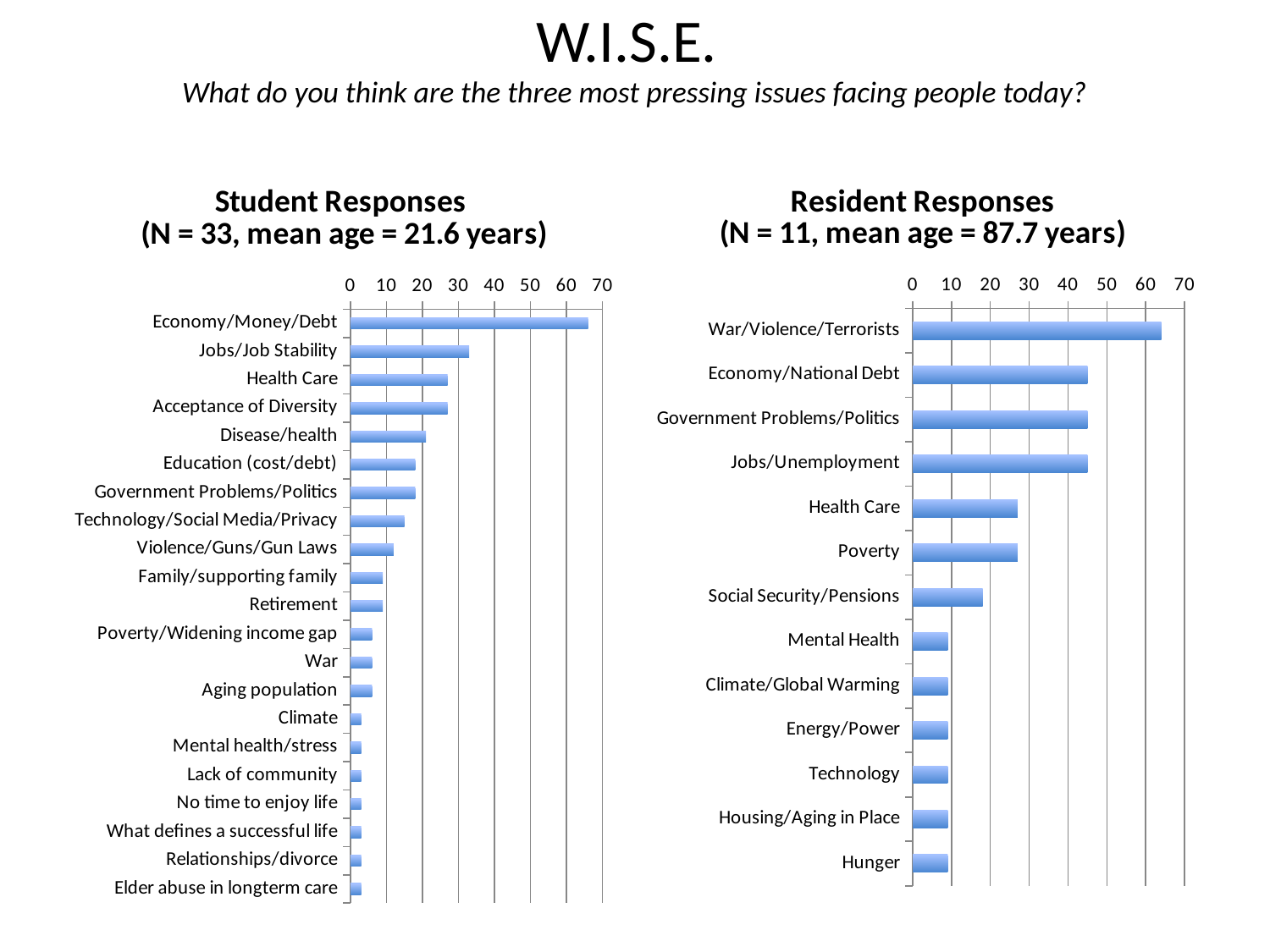
In the Student Responses chart, is the value for Jobs/Job Stability greater or less than 30? greater In the Resident Responses chart, is the value for Social Security/Pensions greater or less than 20? less In the Student Responses chart, which category has the highest value? Economy/Money/Debt How many categories are shown in the Resident Responses chart? 13 What kind of chart is the Student Responses chart? bar chart In the Student Responses chart, which is larger: Economy/Money/Debt or Jobs/Job Stability? Economy/Money/Debt In the Student Responses chart, is the value for Education (cost/debt) greater or less than 20? less In the Resident Responses chart, which category has the highest value? War/Violence/Terrorists How many categories are shown in the Student Responses chart? 21 In the Resident Responses chart, which is larger: Health Care or War/Violence/Terrorists? War/Violence/Terrorists